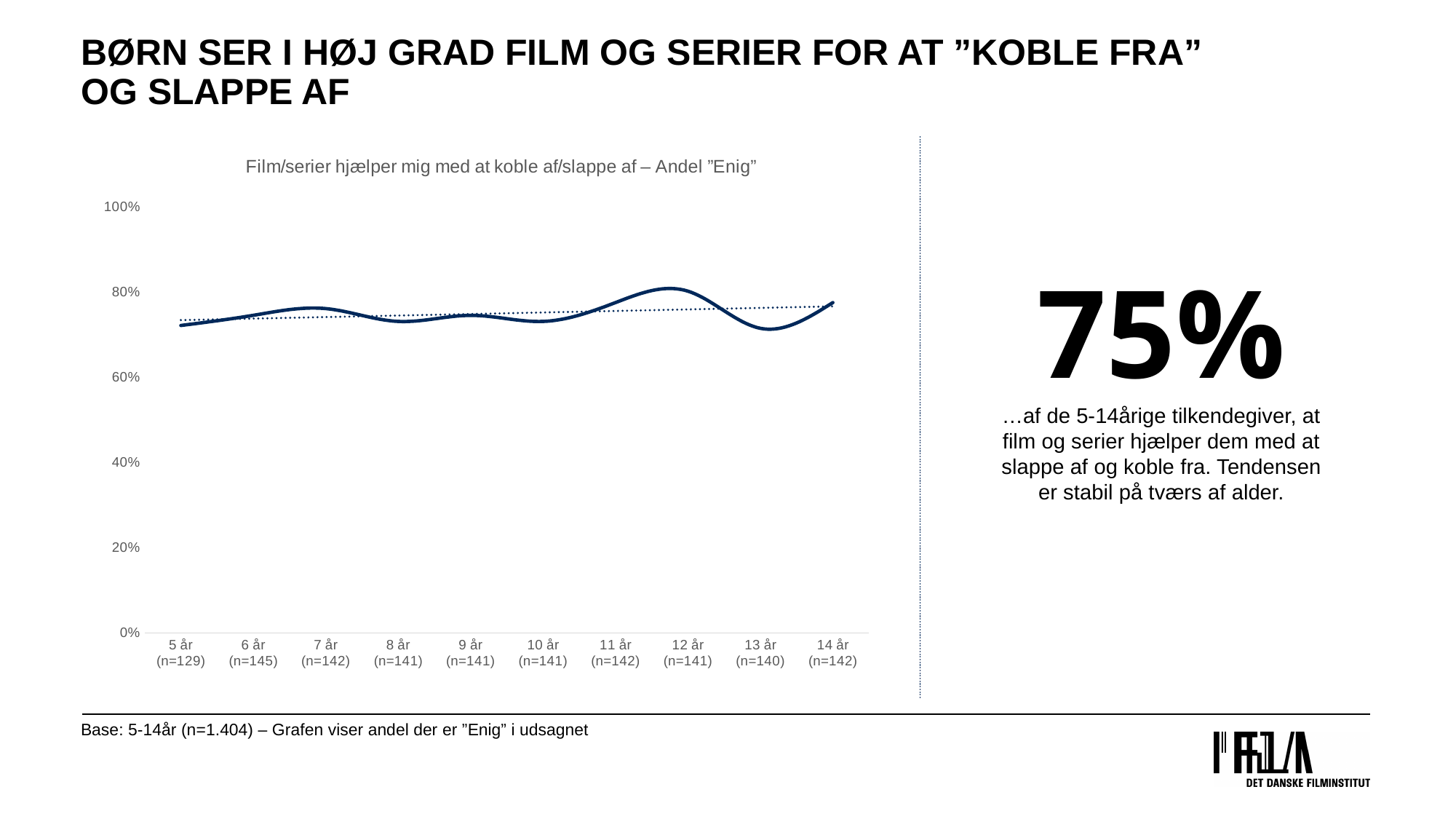
Is the value for 5 år greater or less than 60%? greater How many age categories are plotted along the x axis of the chart? 10 Is the value for 13 år greater or less than 80%? less Is the value for 8 år greater or less than 40%? greater What is the title of the chart? Film/serier hjælper mig med at koble af/slappe af – Andel "Enig" What kind of chart is shown on the slide? line chart What is the sample size (n) shown for the 5 år category? n=129 Which is larger, the value for 12 år or the value for 13 år? 12 år Which age group has the highest share of "Enig" in the chart? 12 år Does the share of "Enig" rise, fall or stay roughly stable across the age groups from 5 år to 14 år? roughly stable Which is larger, the value for 5 år or the value for 12 år? 12 år